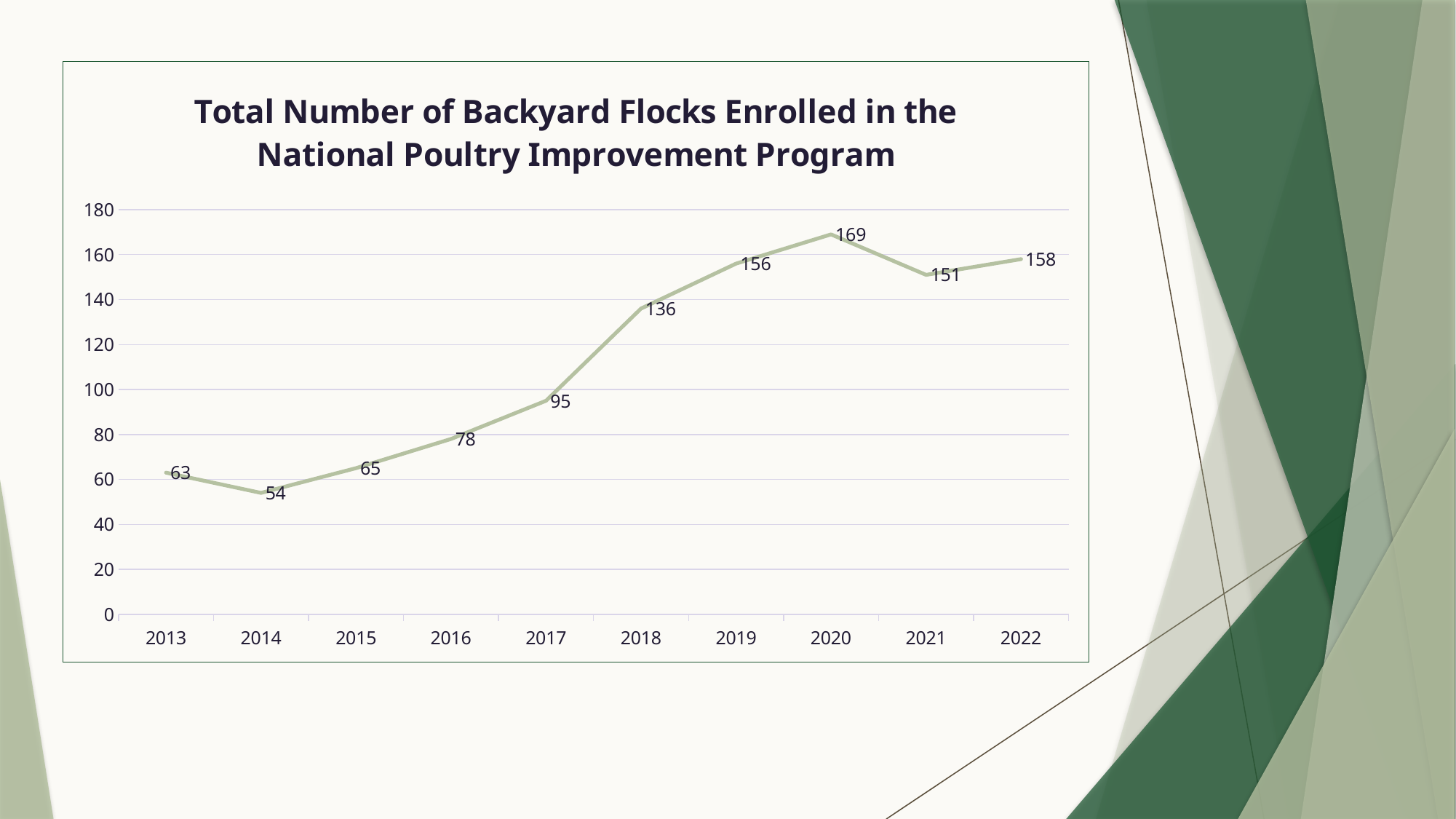
What is the difference between the values for 2020 and 2021? 18 Which year has the lowest number of backyard flocks enrolled? 2014 Which year has the highest number of backyard flocks enrolled? 2020 What is the difference between the values for 2017 and 2013? 32 What is the total number of backyard flocks enrolled in 2018? 136 What is the value for 2014? 54 How many years are plotted on the x axis? 10 What type of chart is shown on the slide? line chart What is the value for 2022? 158 Which year has a larger value, 2019 or 2022? 2022 Is the value for 2016 greater or less than 80? less What is the title of the chart? Total Number of Backyard Flocks Enrolled in the National Poultry Improvement Program